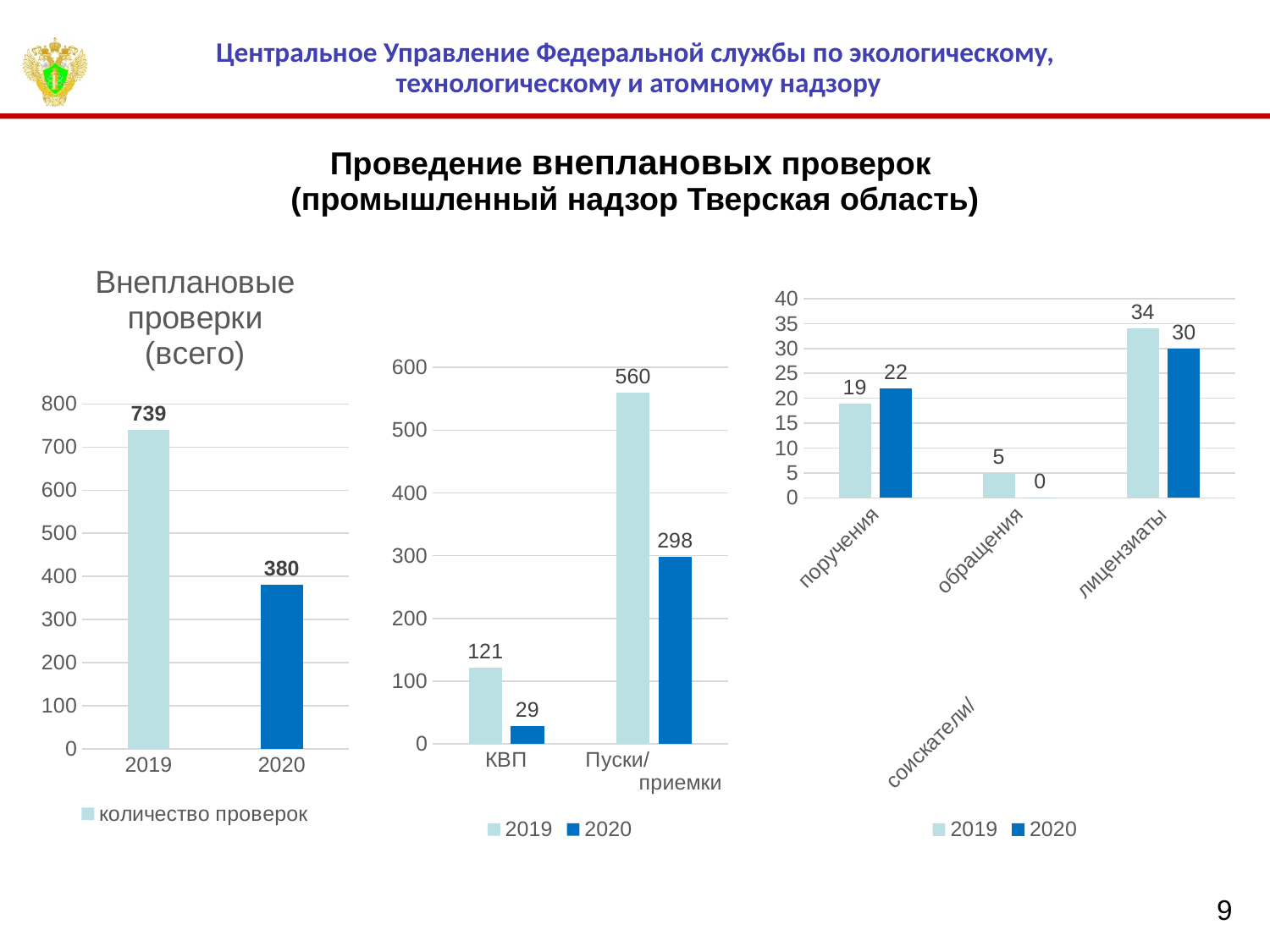
In the middle chart, which category has the highest 2019 value? Пуски/приемки In the right-hand chart, what is the 2020 value for поручения? 22 In the middle chart, what is the difference between the 2019 and 2020 values for Пуски/приемки? 262 In the right-hand chart, which category has the highest 2019 value? лицензиаты In the middle chart, what is the 2019 value for Пуски/приемки? 560 How many series does the legend of the middle chart list? 2 In the right-hand chart, is the 2019 value for поручения or the 2020 value for поручения larger? 2020 In the chart titled "Внеплановые проверки (всего)", what is the value for 2019? 739 In the right-hand chart, what is the 2020 value for обращения? 0 In the middle chart, what is the 2020 value for КВП? 29 In the chart titled "Внеплановые проверки (всего)", what is the value for 2020? 380 In the chart titled "Внеплановые проверки (всего)", what is the difference between the 2019 and 2020 values? 359